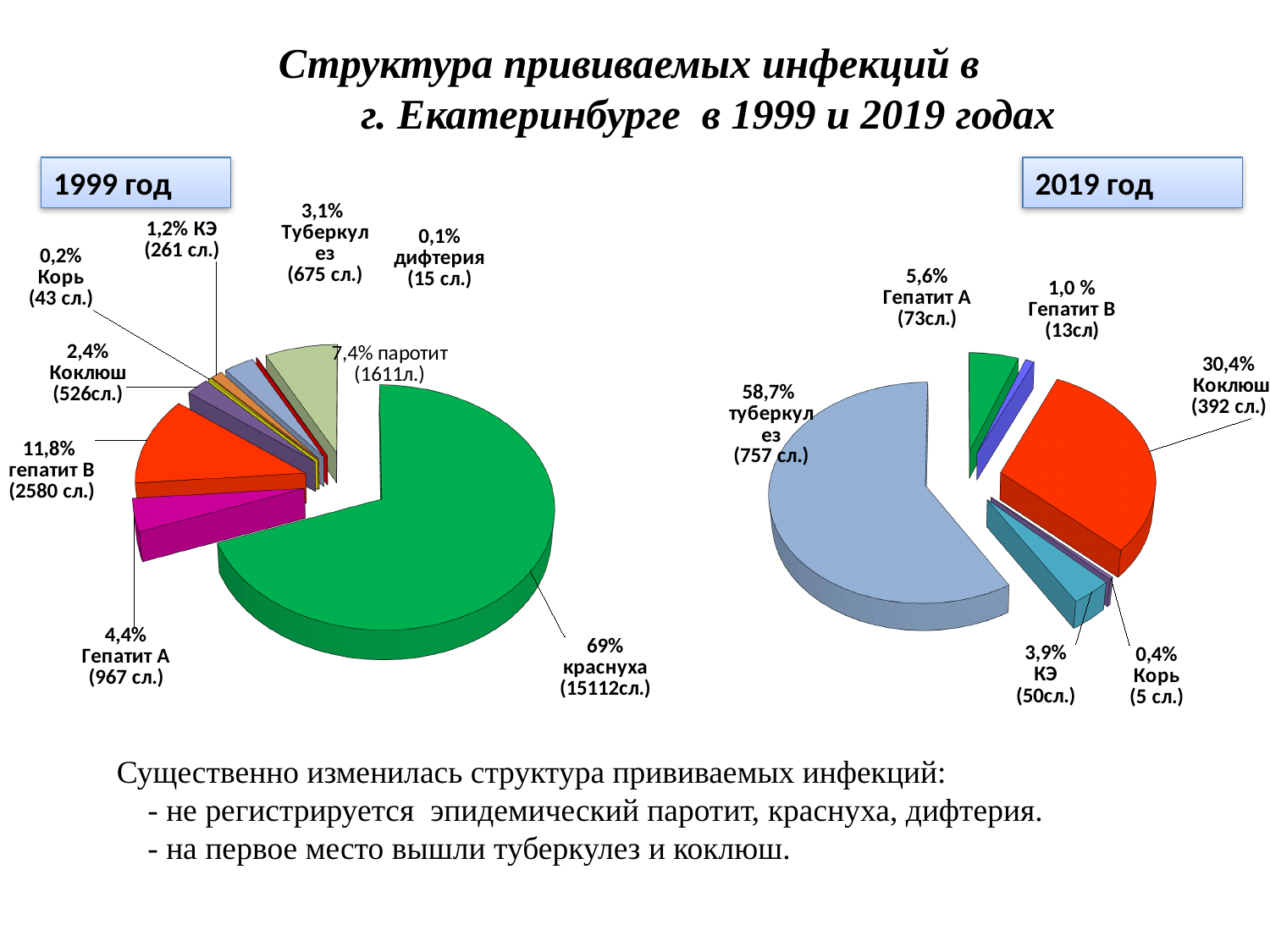
On the 1999 pie chart, which infection has the largest share? краснуха How many categories are shown on the 1999 pie chart? 9 On the 2019 pie chart, which infection has the smallest share? Корь On the 1999 pie chart, how many cases of гепатит В are shown? 2580 сл. On the 1999 pie chart, what share does краснуха have? 69% On the 2019 pie chart, which is larger: the share of Коклюш or the share of Гепатит А? Коклюш On the 2019 pie chart, what is the difference in percentage points between туберкулез and Коклюш? 28,3 On the 1999 pie chart, which infection has the smallest share? дифтерия On the 2019 pie chart, how many cases of Коклюш are shown? 392 сл. On the 2019 pie chart, what share does туберкулез have? 58,7% How many categories are shown on the 2019 pie chart? 6 What type of chart is used for the 1999 and 2019 data? Pie chart